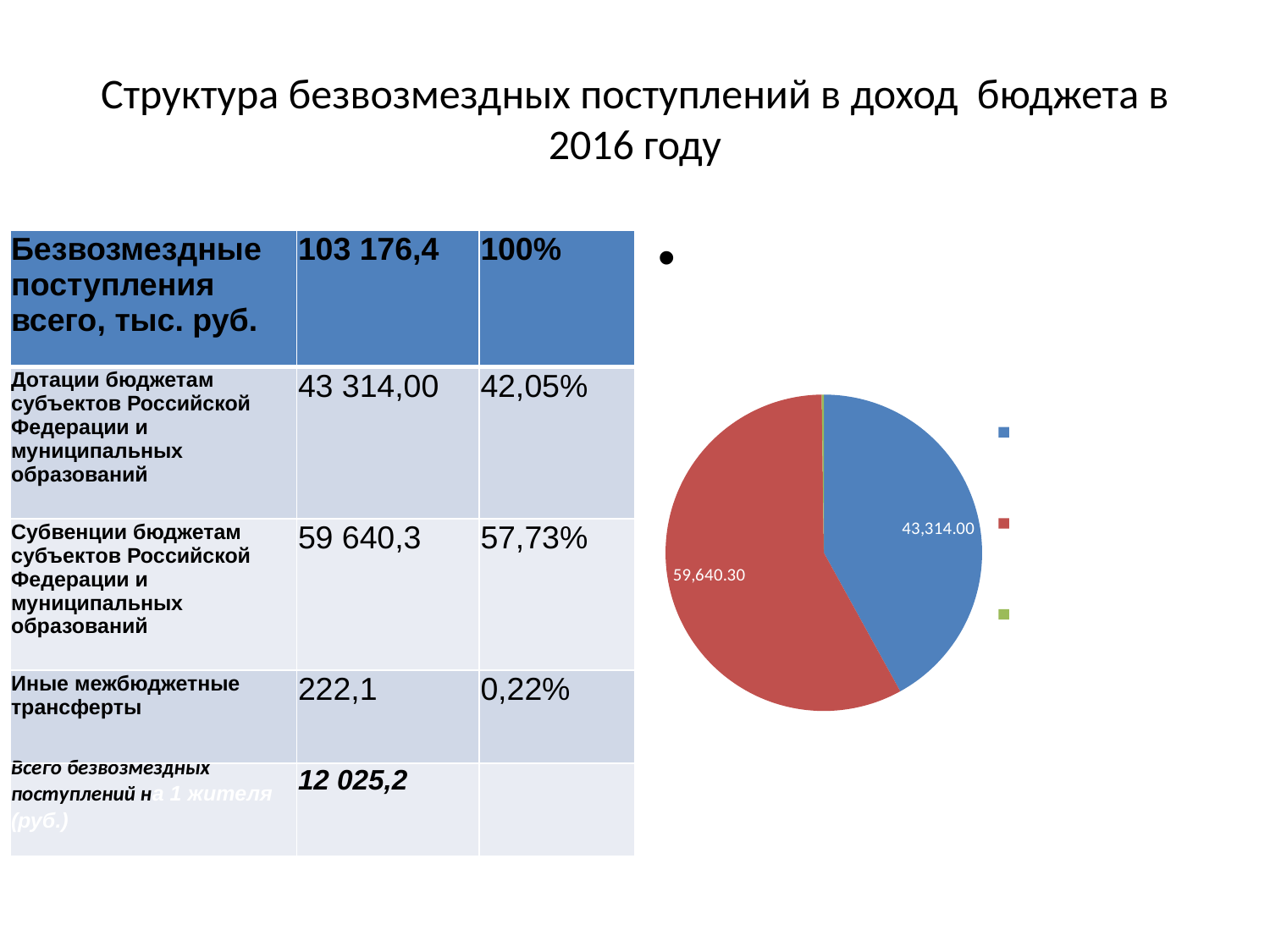
Which slice of the pie chart is the largest? the red slice (59,640.30) What kind of chart is shown on the slide? pie chart Is the value of the blue slice in the pie chart greater or less than 50,000? less Which slice of the pie chart is the smallest? the green slice How many slices does the pie chart have? 3 What value is printed on the red slice of the pie chart? 59,640.30 How many entries does the pie chart's legend list? 3 What colour is the largest slice of the pie chart? red Which is larger in the pie chart, the blue slice or the red slice? the red slice What is the difference between the red slice value and the blue slice value in the pie chart? 16,326.30 What value is printed on the blue slice of the pie chart? 43,314.00